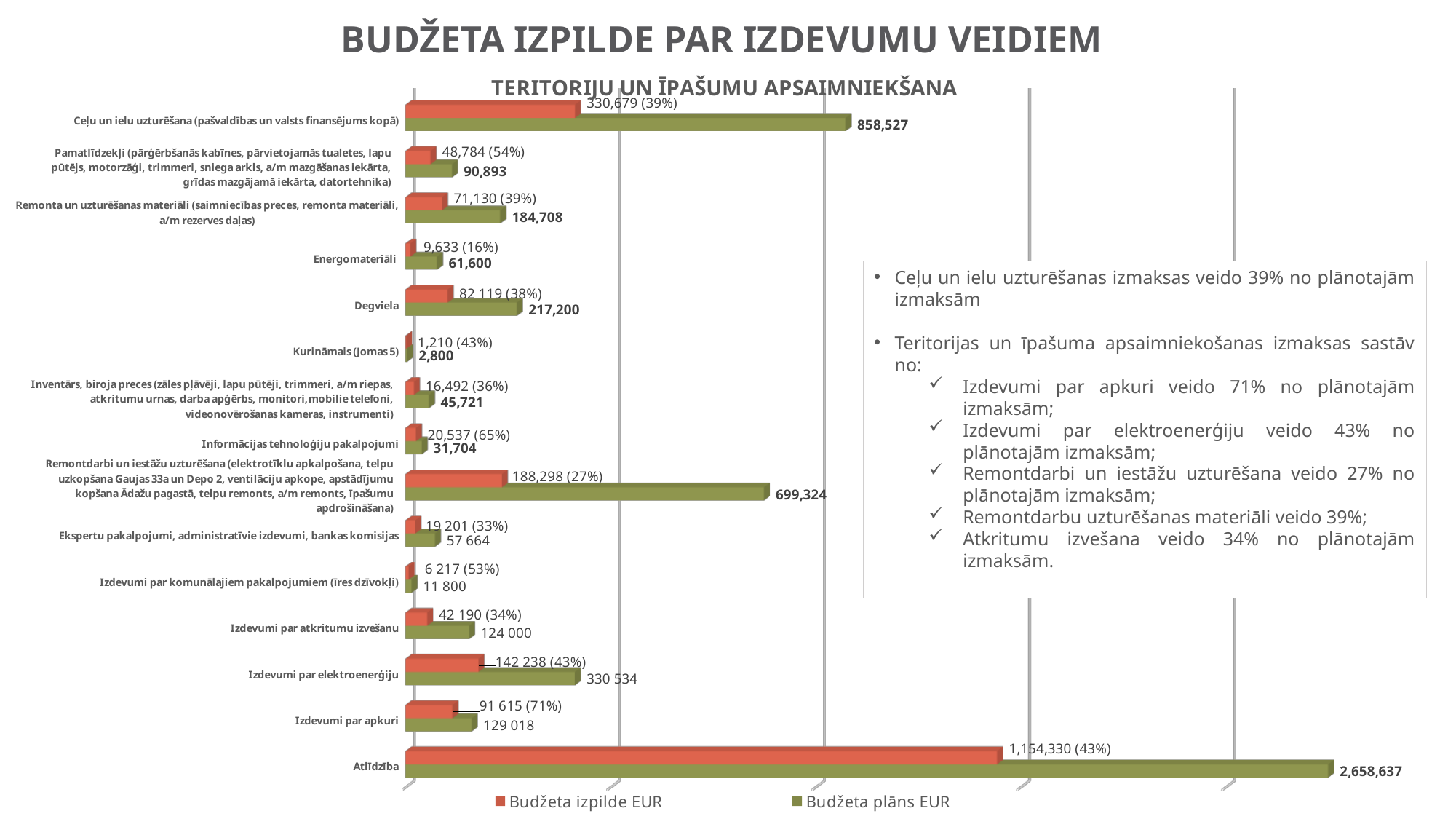
What is the Budžeta izpilde EUR value for Izdevumi par apkuri? 91 615 What is the Budžeta plāns EUR value for Remontdarbi un iestāžu uzturēšana? 699,324 What type of chart is shown on the slide? Bar chart How many series does the legend list? 2 What is the difference between the Budžeta plāns EUR and Budžeta izpilde EUR values for Degviela? 135,081 What percentage of the plan is shown next to the Budžeta izpilde EUR value for Energomateriāli? 16% Which category has the highest Budžeta plāns EUR value? Atlīdzība Which category has the lowest Budžeta plāns EUR value? Kurināmais (Jomas 5) How many categories are plotted on the chart? 15 Which is larger, the Budžeta izpilde EUR value for Izdevumi par elektroenerģiju or for Izdevumi par apkuri? Izdevumi par elektroenerģiju What is the title of the chart? TERITORIJU UN ĪPAŠUMU APSAIMNIEKŠANA What is the Budžeta plāns EUR value for Degviela? 217,200